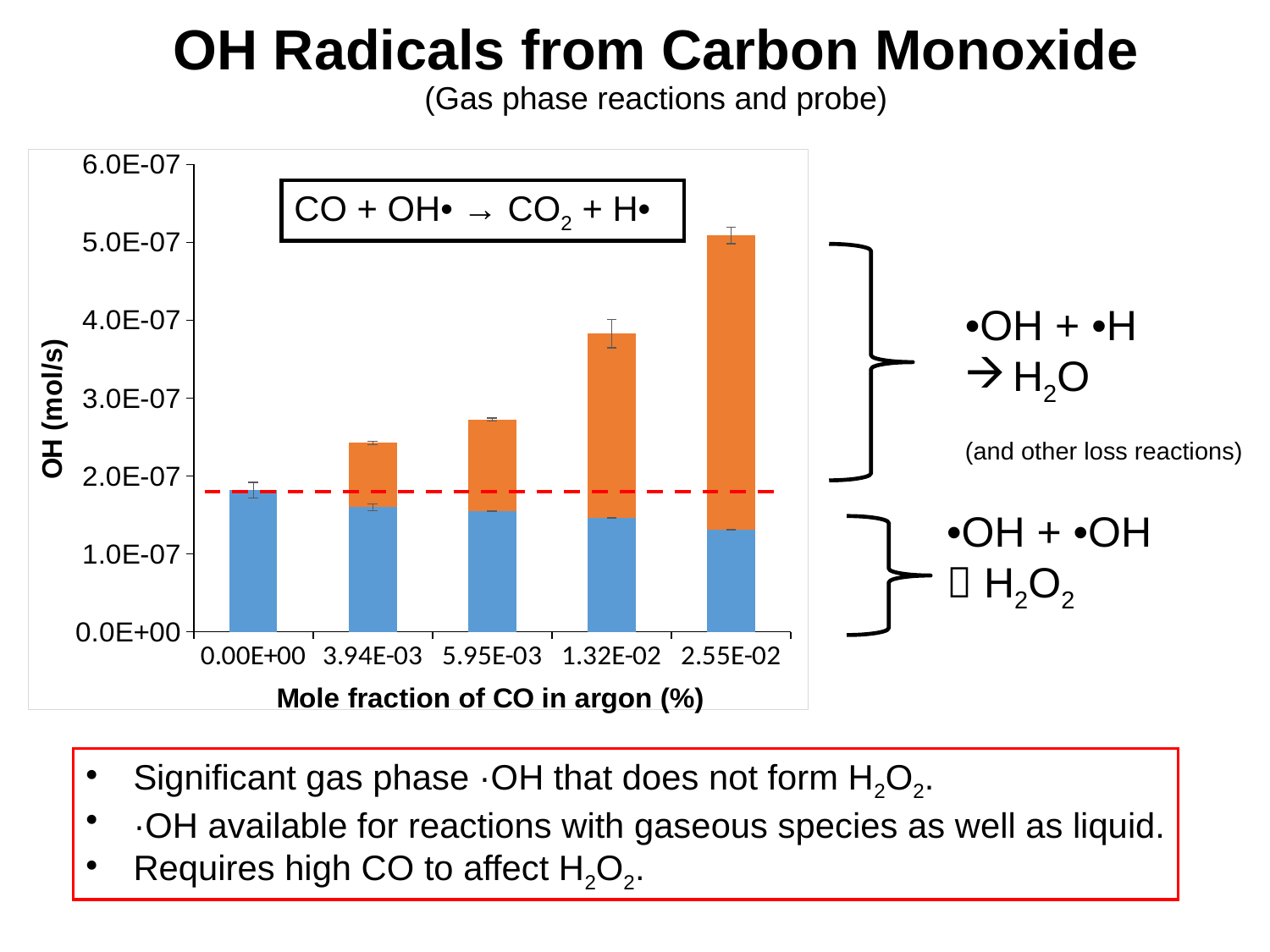
Which mole fraction of CO has the smallest blue (bottom) segment? 2.55E-02 Do the total bar heights rise or fall as the mole fraction of CO increases along the x axis? rise Is the total bar height for 0.00E+00 greater or less than 2.0E-07? less Is the total bar height for 2.55E-02 greater or less than 4.0E-07? greater Is the total bar height for 1.32E-02 greater or less than 3.0E-07? greater How many mole fraction categories are plotted on the x axis? 5 Which mole fraction of CO has the tallest total bar? 2.55E-02 Which mole fraction of CO has the largest blue (bottom) segment? 0.00E+00 What kind of chart is shown on the slide? stacked bar chart Which mole fraction of CO has the shortest total bar? 0.00E+00 What is the label of the y axis? OH (mol/s) Which has the taller total bar, 1.32E-02 or 5.95E-03? 1.32E-02